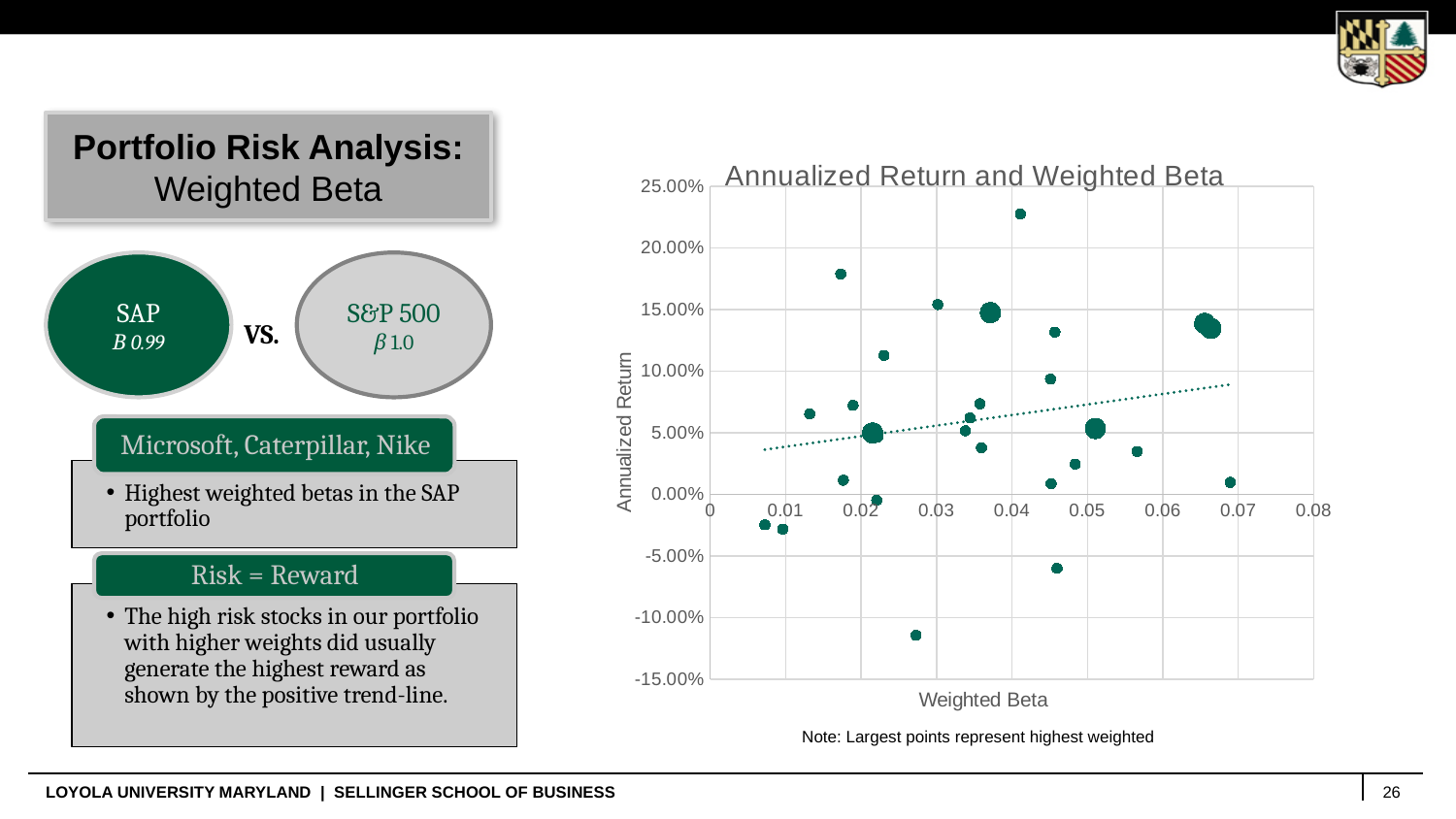
What is the title of the chart on the slide? Annualized Return and Weighted Beta Is the highest annualized return plotted in the chart greater or less than 20.00%? greater What kind of chart is shown on the slide? scatter chart According to the note under the chart, what do the largest points represent? highest weighted Is the lowest annualized return plotted in the chart greater or less than -10.00%? less According to the dotted trend line in the chart, does annualized return rise or fall as weighted beta increases? rise